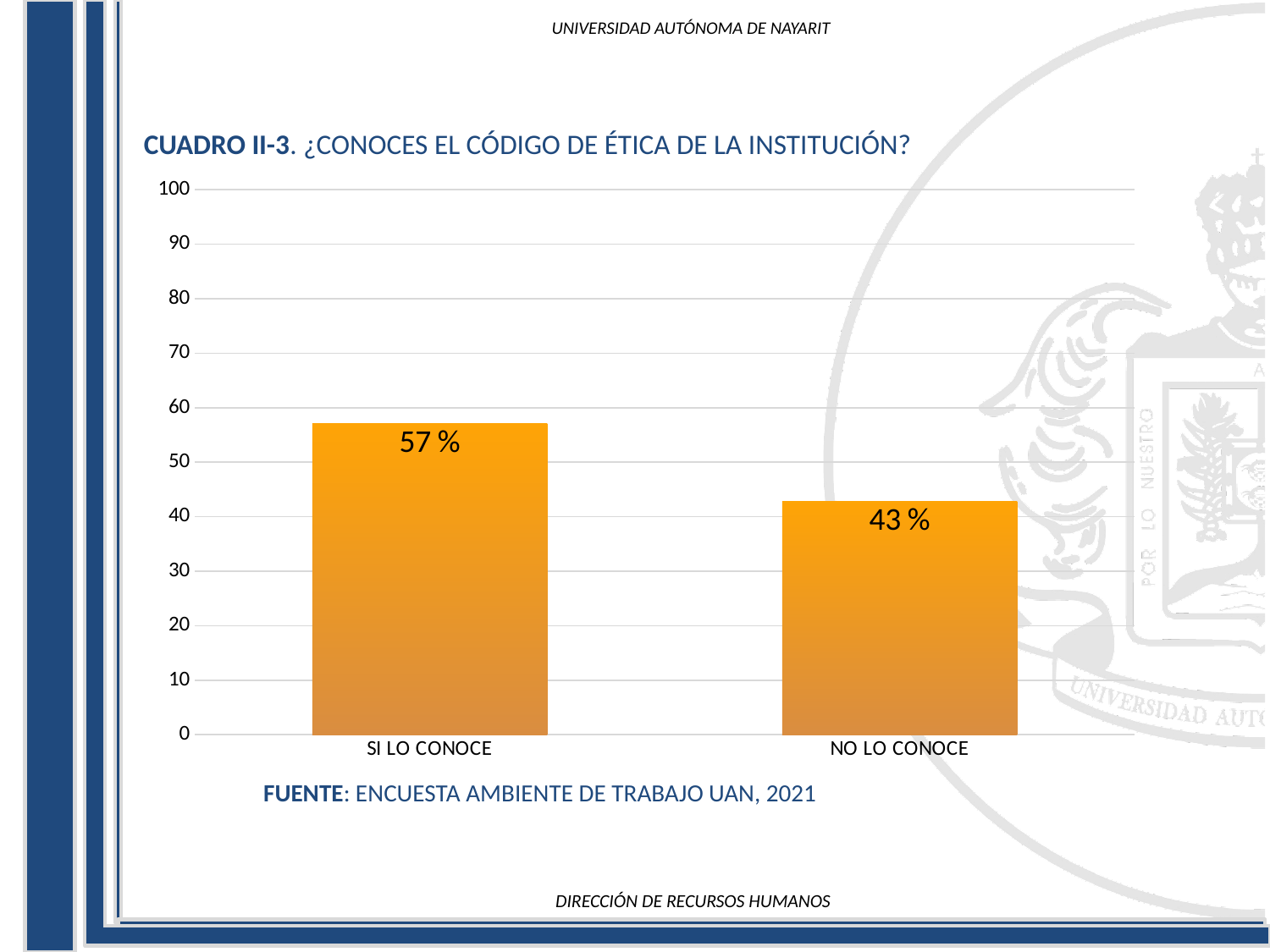
Which category has the lowest value? NO LO CONOCE What is the difference between the values for SI LO CONOCE and NO LO CONOCE? 14 % Which category has the highest value? SI LO CONOCE What source is cited below the chart? ENCUESTA AMBIENTE DE TRABAJO UAN, 2021 Is the value for NO LO CONOCE greater or less than 50? less What kind of chart is shown on the slide? bar chart How many categories are shown on the chart? 2 What is the value for NO LO CONOCE? 43 % Which is larger, the value for SI LO CONOCE or the value for NO LO CONOCE? SI LO CONOCE What is the title of the chart? CUADRO II-3. ¿CONOCES EL CÓDIGO DE ÉTICA DE LA INSTITUCIÓN? Is the value for SI LO CONOCE greater or less than 50? greater What is the value for SI LO CONOCE? 57 %